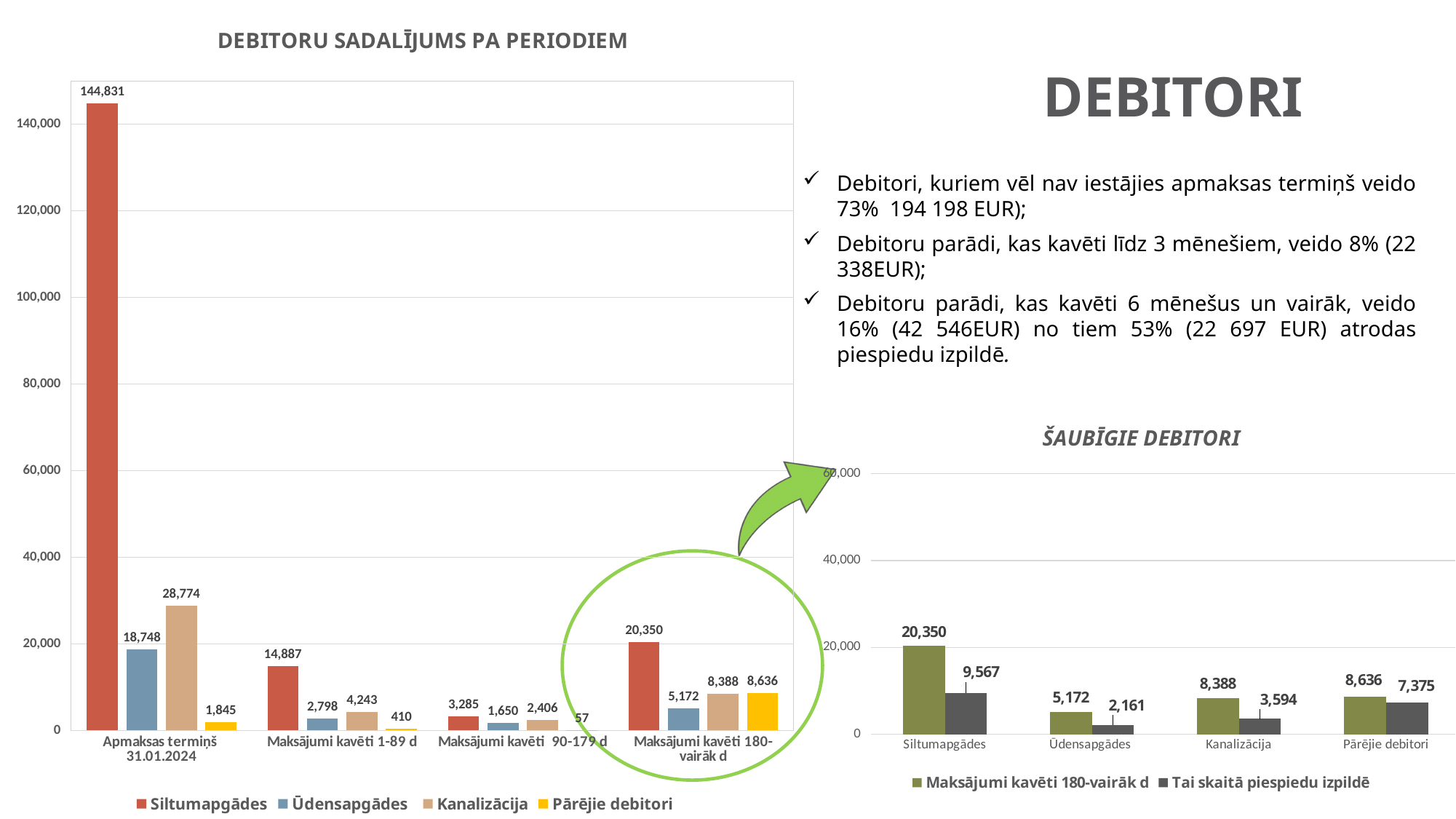
In the chart 'ŠAUBĪGIE DEBITORI', what is the value for 'Tai skaitā piespiedu izpildē' for Siltumapgādes? 9,567 In the chart 'DEBITORU SADALĪJUMS PA PERIODIEM', what is the value for Kanalizācija in the category 'Maksājumi kavēti 1-89 d'? 4,243 In the chart 'ŠAUBĪGIE DEBITORI', which is larger for Pārējie debitori: 'Maksājumi kavēti 180-vairāk d' or 'Tai skaitā piespiedu izpildē'? Maksājumi kavēti 180-vairāk d In the chart 'DEBITORU SADALĪJUMS PA PERIODIEM', how many categories are shown on the x axis? 4 In the chart 'ŠAUBĪGIE DEBITORI', what is the difference between 'Maksājumi kavēti 180-vairāk d' and 'Tai skaitā piespiedu izpildē' for Kanalizācija? 4,794 What type of chart is 'ŠAUBĪGIE DEBITORI'? Bar chart In the chart 'DEBITORU SADALĪJUMS PA PERIODIEM', which series has the highest value in the category 'Apmaksas termiņš 31.01.2024'? Siltumapgādes In the chart 'DEBITORU SADALĪJUMS PA PERIODIEM', which series has the lowest value in the category 'Maksājumi kavēti 1-89 d'? Pārējie debitori In the chart 'DEBITORU SADALĪJUMS PA PERIODIEM', how many series does the legend list? 4 In the chart 'DEBITORU SADALĪJUMS PA PERIODIEM', what is the value for Siltumapgādes in the category 'Apmaksas termiņš 31.01.2024'? 144,831 In the chart 'DEBITORU SADALĪJUMS PA PERIODIEM', what is the value for Pārējie debitori in the category 'Maksājumi kavēti 90-179 d'? 57 In the chart 'DEBITORU SADALĪJUMS PA PERIODIEM', what is the difference between Kanalizācija and Ūdensapgādes in the category 'Apmaksas termiņš 31.01.2024'? 10,026